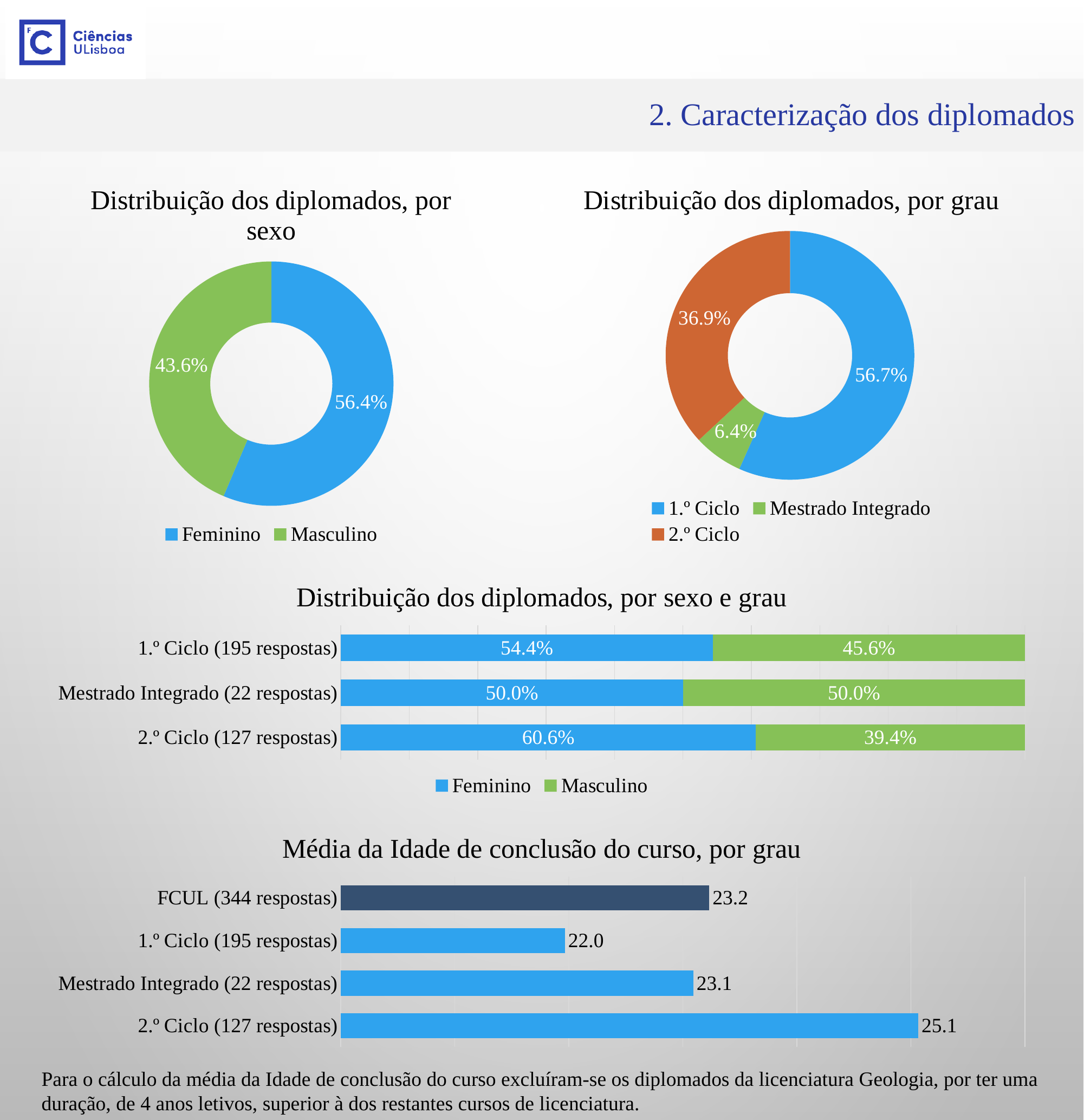
In the chart 'Distribuição dos diplomados, por grau', how many categories does the legend list? 3 In the chart 'Distribuição dos diplomados, por sexo', what is the share for Feminino? 56.4% In the chart 'Distribuição dos diplomados, por sexo e grau', what is the Feminino value for 2.º Ciclo (127 respostas)? 60.6% In the chart 'Distribuição dos diplomados, por sexo e grau', what is the Masculino value for 1.º Ciclo (195 respostas)? 45.6% In the chart 'Distribuição dos diplomados, por grau', which category has the smallest share? Mestrado Integrado What kind of chart is 'Média da Idade de conclusão do curso, por grau'? Bar chart In the chart 'Distribuição dos diplomados, por sexo', what is the share for Masculino? 43.6% In the chart 'Distribuição dos diplomados, por grau', what is the difference between the 1.º Ciclo share and the 2.º Ciclo share? 19.8% In the chart 'Média da Idade de conclusão do curso, por grau', what is the value for 2.º Ciclo (127 respostas)? 25.1 In the chart 'Média da Idade de conclusão do curso, por grau', which category has the lowest value? 1.º Ciclo (195 respostas) In the chart 'Distribuição dos diplomados, por grau', what is the share for 2.º Ciclo? 36.9% In the chart 'Distribuição dos diplomados, por sexo e grau', how many series does the legend list? 2